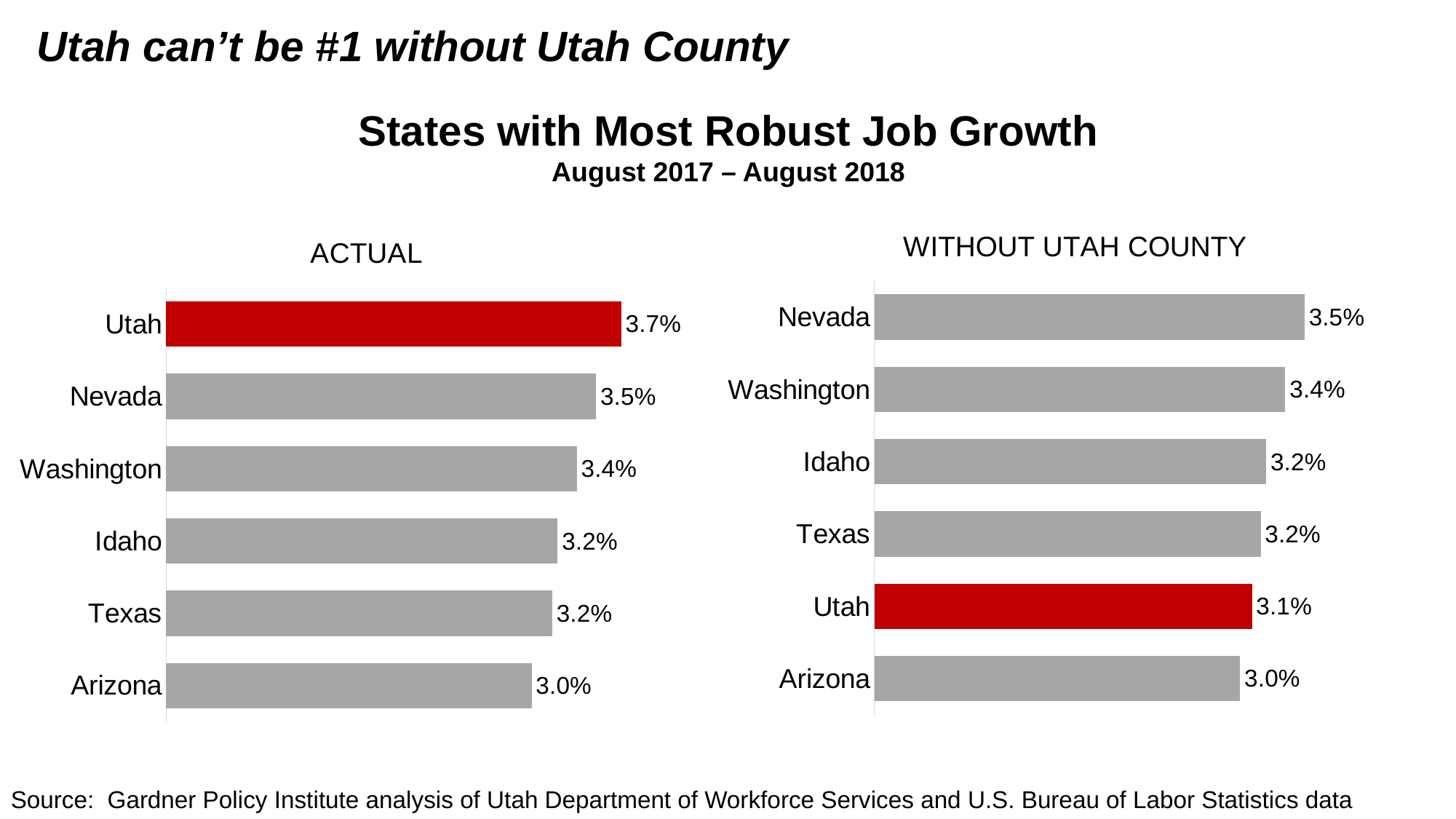
How many states are shown in the ACTUAL chart? 6 In the ACTUAL chart, which state has the lowest job growth? Arizona In the WITHOUT UTAH COUNTY chart, which state has the highest job growth? Nevada In the ACTUAL chart, which state's bar is coloured red? Utah In the ACTUAL chart, which state has the highest job growth? Utah In the ACTUAL chart, what is the difference between Utah's value and Nevada's value? 0.2% What is the difference between Utah's value in the ACTUAL chart and its value in the WITHOUT UTAH COUNTY chart? 0.6% In the ACTUAL chart, what is the job growth value for Utah? 3.7% In the WITHOUT UTAH COUNTY chart, what is the value for Washington? 3.4% In the WITHOUT UTAH COUNTY chart, which is larger, the value for Washington or the value for Arizona? Washington In the WITHOUT UTAH COUNTY chart, what is the job growth value for Utah? 3.1% What kind of chart is the WITHOUT UTAH COUNTY chart? Bar chart